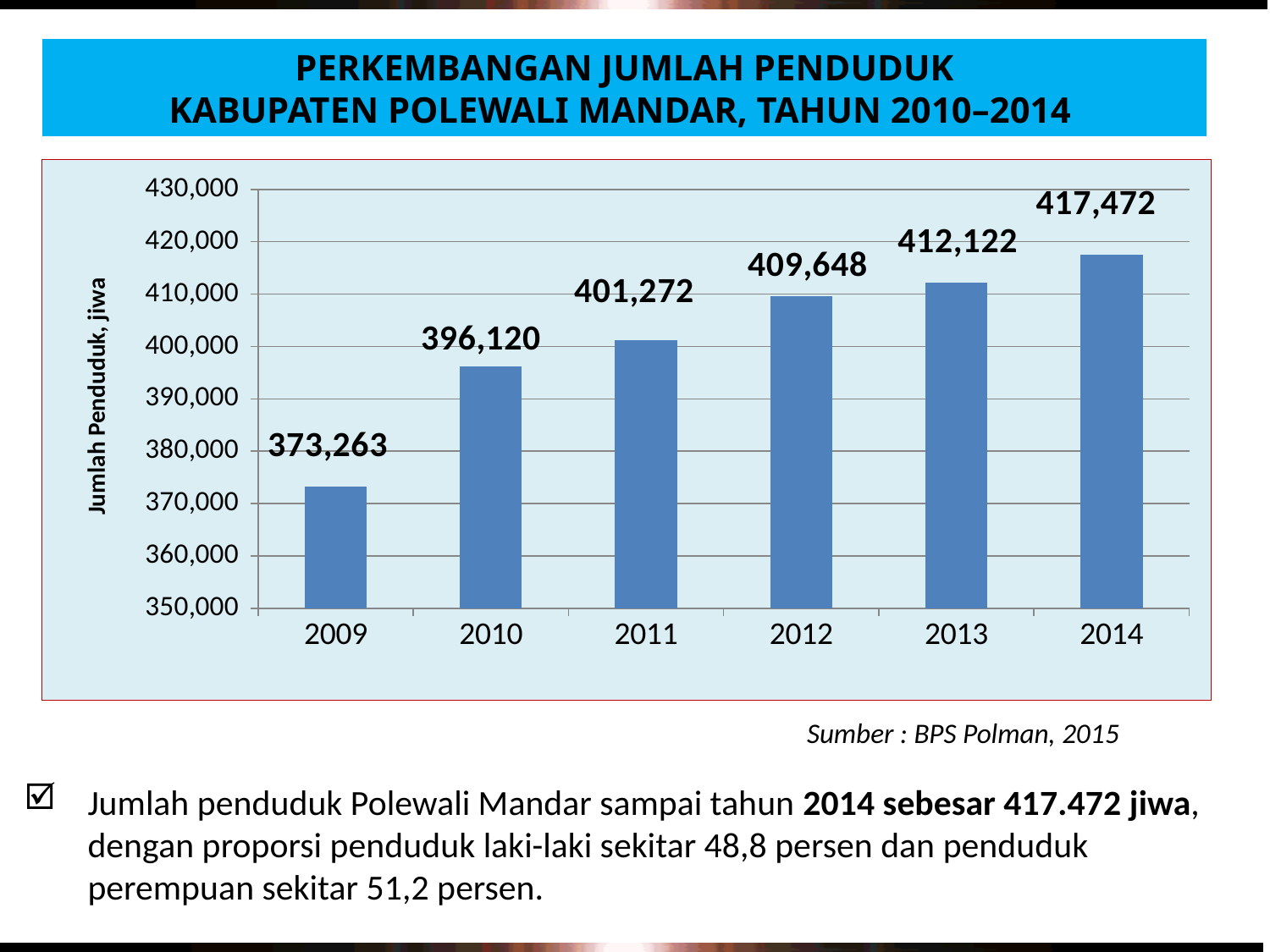
Which year has the lowest population value? 2009 Which year has the highest population value? 2014 Is the value for 2011 greater or less than 400,000? greater How many years are shown on the x axis of the chart? 6 What kind of chart is shown on the slide? bar chart Do the population values rise or fall from 2009 to 2014? rise What is the population value shown for 2014? 417,472 What is the difference between the population values for 2010 and 2009? 22,857 What is the population value shown for 2012? 409,648 What is the difference between the population values for 2014 and 2013? 5,350 What is the population value shown for 2009? 373,263 Which year has a larger population value, 2011 or 2013? 2013